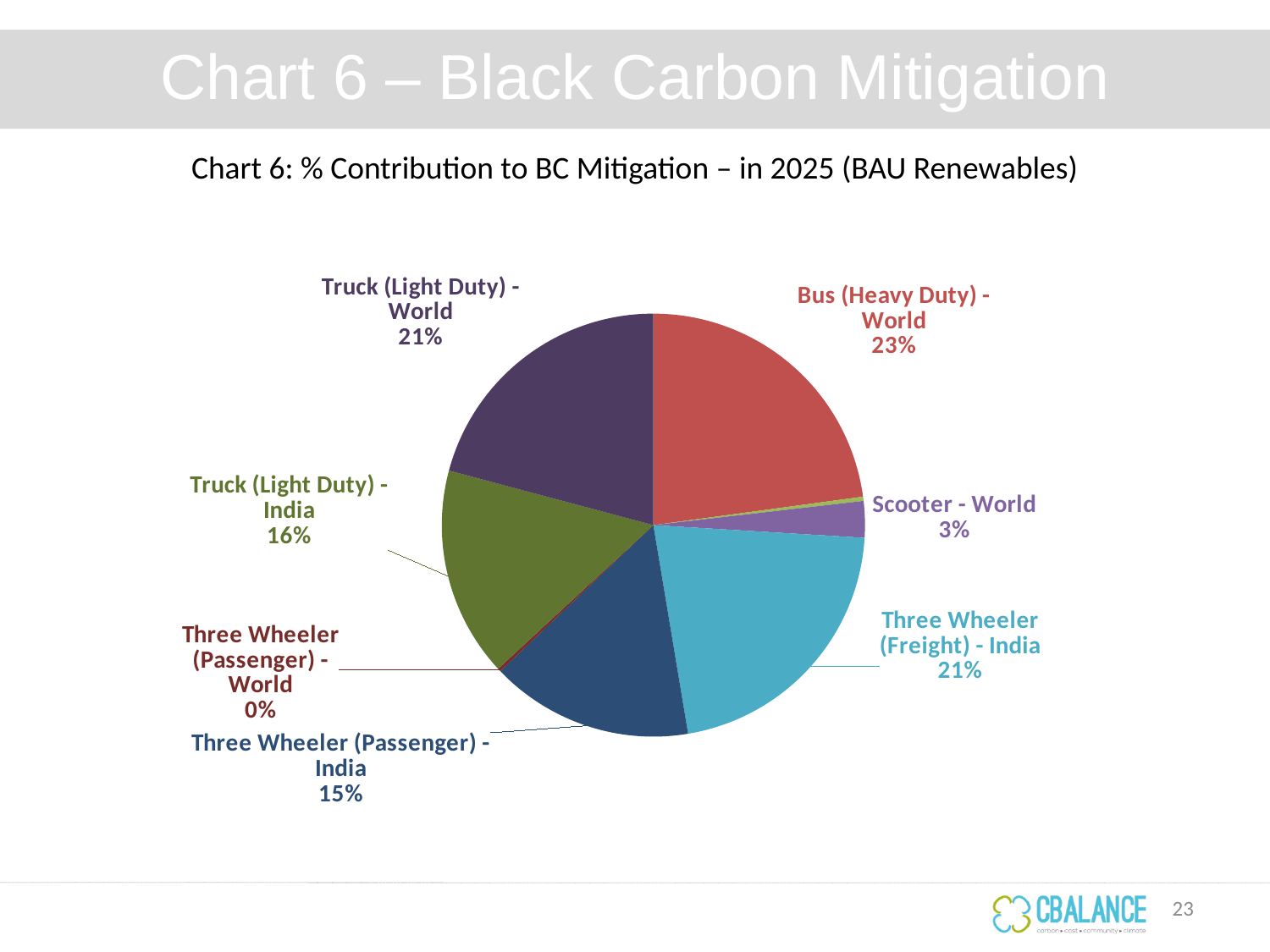
What is the percentage contribution of Scooter - World? 3% What is the difference in percentage points between Bus (Heavy Duty) - World and Truck (Light Duty) - World? 2 percentage points What is the percentage contribution of Truck (Light Duty) - India? 16% What is the difference in percentage points between Truck (Light Duty) - World and Truck (Light Duty) - India? 5 percentage points What is the percentage contribution of Bus (Heavy Duty) - World? 23% What is the percentage contribution of Three Wheeler (Passenger) - India? 15% What is the title of the chart? Chart 6: % Contribution to BC Mitigation – in 2025 (BAU Renewables) Which category has the smallest share of the pie? Three Wheeler (Passenger) - World Which is larger: Truck (Light Duty) - India or Three Wheeler (Passenger) - India? Truck (Light Duty) - India What type of chart is shown on the slide? Pie chart Which category has the largest share of the pie? Bus (Heavy Duty) - World What is the percentage contribution of Three Wheeler (Freight) - India? 21%